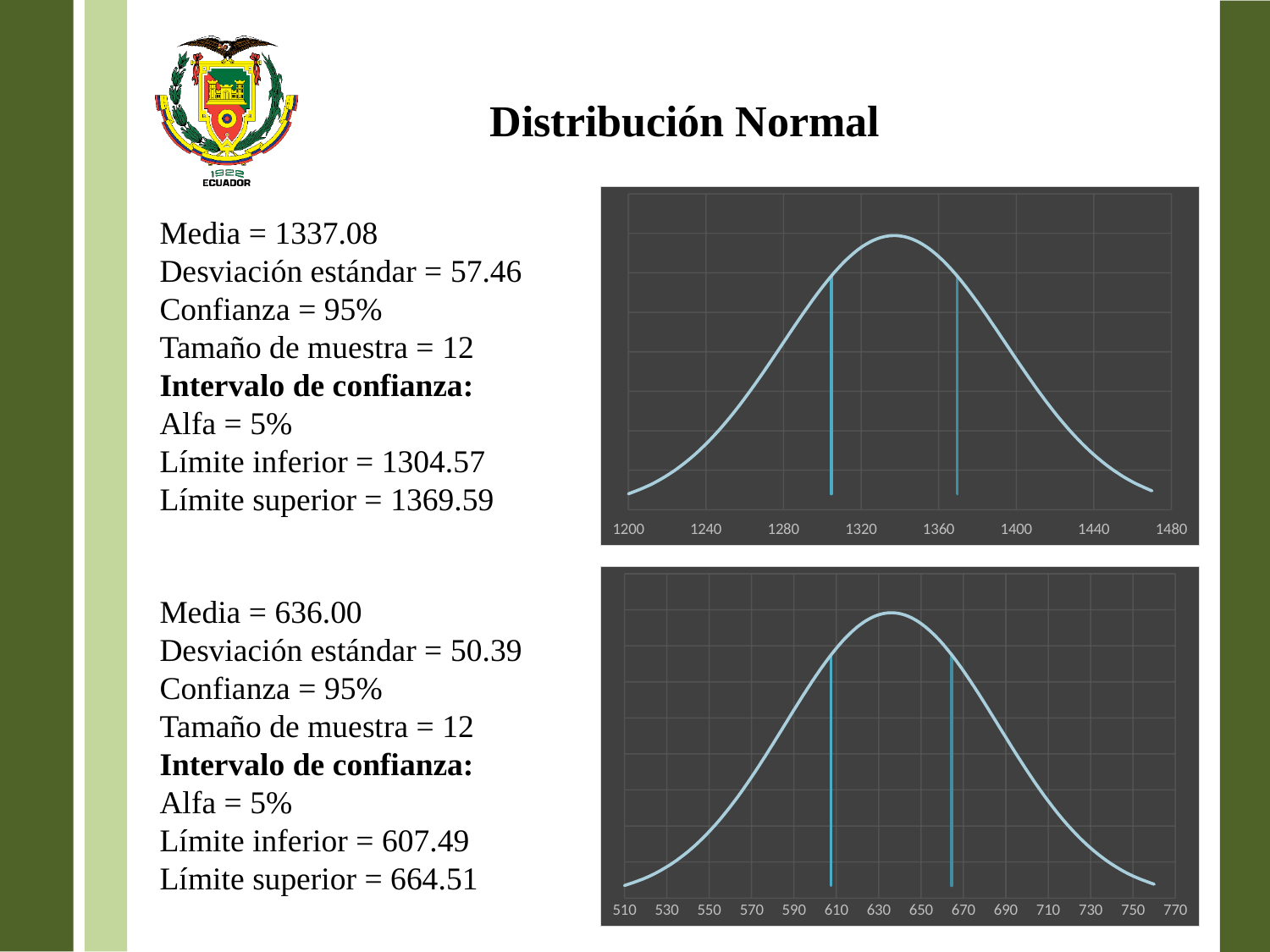
In the bottom chart, what is the first tick label on the x axis? 510 In the bottom chart, what is the last tick label on the x axis? 770 In the top chart, does the curve rise or fall as the x axis goes from 1360 to 1480? fall What kind of chart is the top chart on the slide? line chart What kind of chart is the bottom chart on the slide? line chart In the bottom chart, is the peak of the curve located at an x value greater or less than 610? greater How many charts are shown on the slide? 2 In the top chart, what is the first tick label on the x axis? 1200 In the top chart, how many vertical lines are drawn under the curve? 2 In the top chart, what is the last tick label on the x axis? 1480 In the top chart, does the curve rise or fall as the x axis goes from 1200 to 1320? rise In the bottom chart, does the curve rise or fall as the x axis goes from 650 to 770? fall